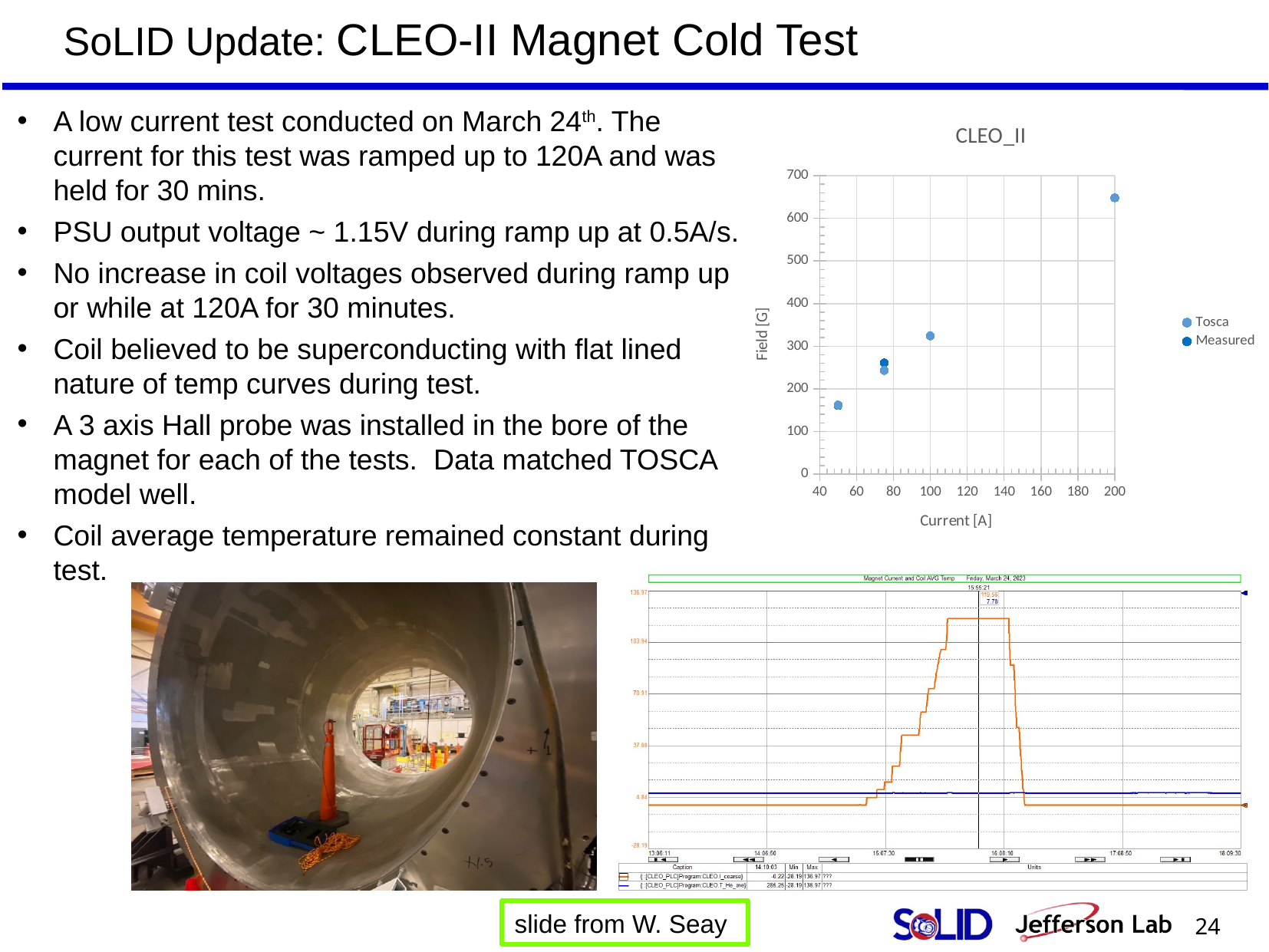
In the CLEO_II chart, which point has the highest field value: the one at 200 A or the one at 100 A? the one at 200 A In the CLEO_II chart, does the field rise or fall as the current increases? rises In the CLEO_II chart, what kind of chart is used to show Field versus Current? scatter chart In the CLEO_II chart, is the field value at 100 A greater or less than 400 G? less In the CLEO_II chart, what is the highest value shown on the Current [A] axis? 200 In the CLEO_II chart, what is the highest value shown on the Field [G] axis? 700 In the CLEO_II chart, is the field value at 100 A greater or less than 300 G? greater What is the label of the y axis in the CLEO_II chart? Field [G] What are the two series named in the legend of the CLEO_II chart? Tosca and Measured In the CLEO_II chart, is the field value at 50 A greater or less than 200 G? less How many series does the legend of the CLEO_II chart list? 2